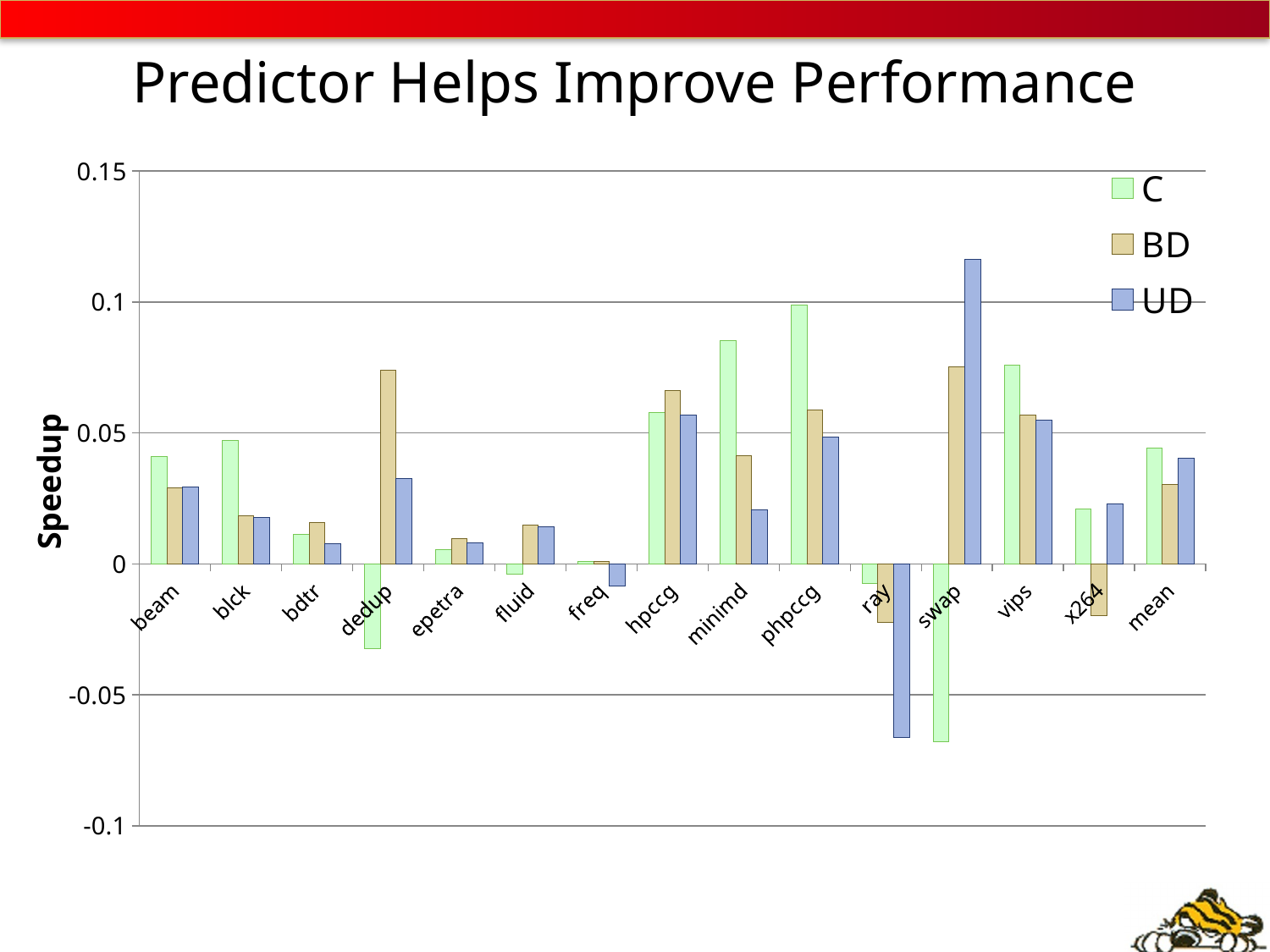
What is the label on the y axis? Speedup For dedup, which series has the larger value, C or BD? BD For minimd, which series has the larger value, C or UD? C Which category has the highest C value? phpccg What kind of chart is shown on the slide? bar chart Is the UD value for swap greater or less than 0.1? greater Which category has the lowest C value? swap Which category has the highest UD value? swap Is the UD value for ray greater or less than -0.05? less How many series does the legend list? 3 How many categories are shown along the x axis? 15 Is the C value for phpccg greater or less than 0.05? greater